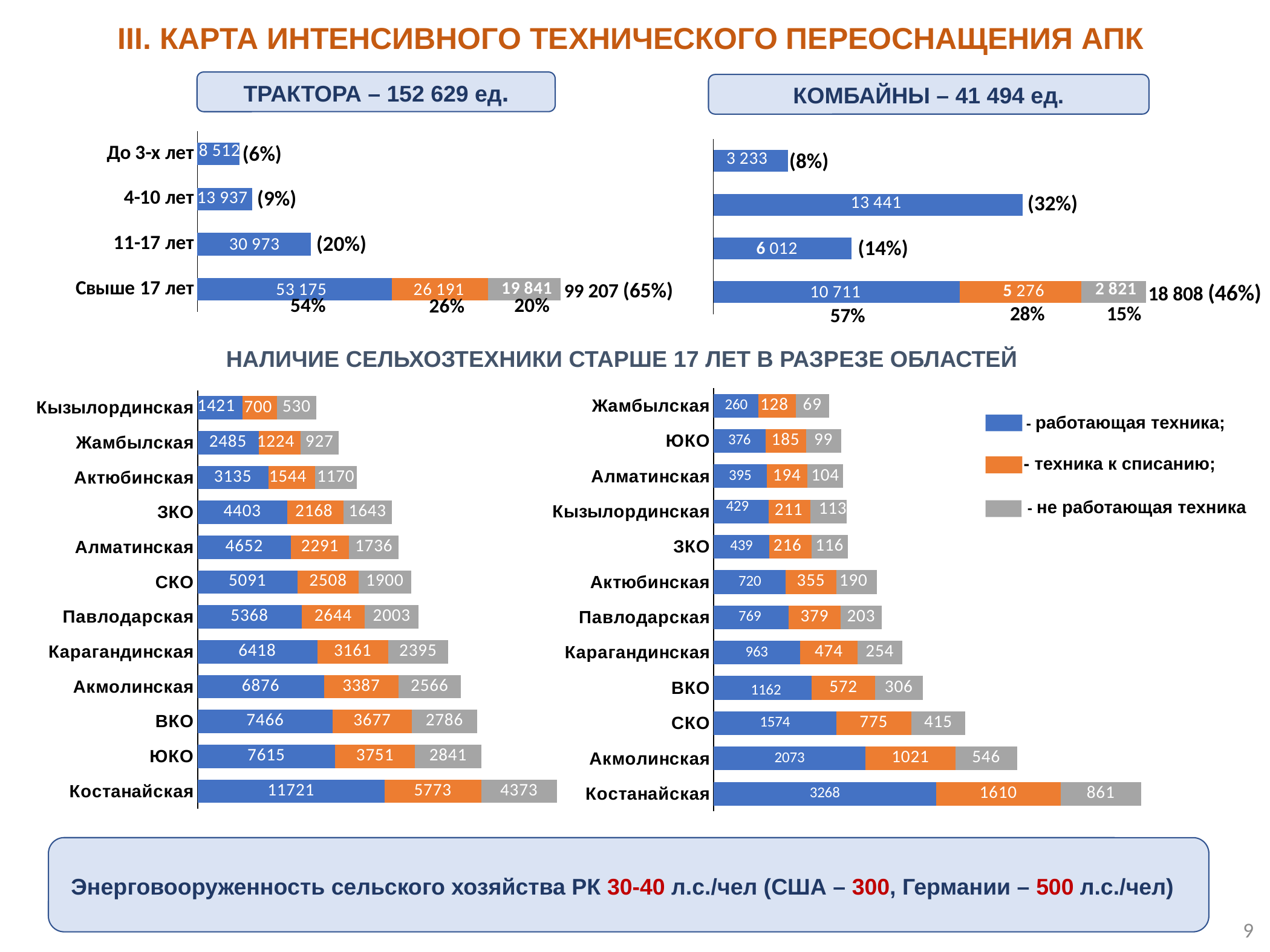
What type of chart is used in the bottom-right chart (combines older than 17 years by region)? Stacked bar chart In the top-left chart (ТРАКТОРА – 152 629 ед.), what is the value for the 11-17 лет age group? 30 973 In the top-right chart (КОМБАЙНЫ – 41 494 ед.), what is the difference between the working equipment (blue) and equipment to be written off (orange) segments for Свыше 17 лет? 5 435 How many regions are shown in the bottom-left chart (tractors older than 17 years by region)? 12 In the top-right chart (КОМБАЙНЫ – 41 494 ед.), what is the value for the 4-10 лет age group? 13 441 How many series does the legend list for the bottom charts (НАЛИЧИЕ СЕЛЬХОЗТЕХНИКИ СТАРШЕ 17 ЛЕТ В РАЗРЕЗЕ ОБЛАСТЕЙ)? 3 In the top-left chart (ТРАКТОРА – 152 629 ед.), what is the total of the stacked bar for Свыше 17 лет? 99 207 In the bottom-left chart (tractors older than 17 years by region), what is the working equipment (blue) value for Костанайская? 11721 In the top-left chart (ТРАКТОРА – 152 629 ед.), which age group has the lowest value? До 3-х лет In the bottom-right chart (combines older than 17 years by region), what is the техника к списанию (orange) value for Акмолинская? 1021 In the top-right chart (КОМБАЙНЫ – 41 494 ед.), which age group has the highest total value? Свыше 17 лет In the bottom-left chart (tractors older than 17 years by region), which has the larger working equipment (blue) value, ВКО or ЮКО? ЮКО